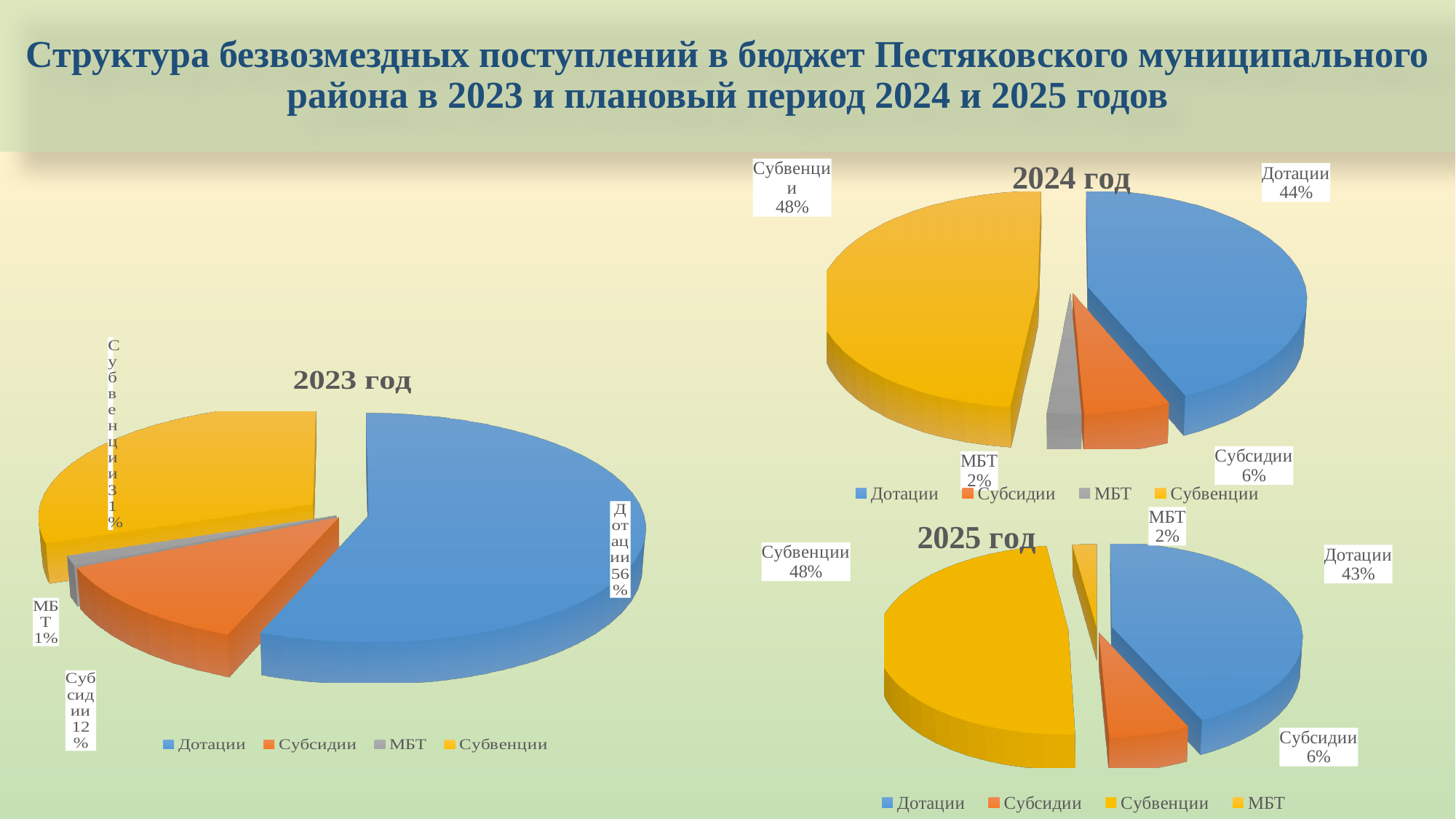
In the "2023 год" chart, which category has the smallest share? МБТ In the "2025 год" chart, what is the difference between the shares of Субвенции and Дотации? 5% In the "2025 год" chart, which is larger, Субсидии or МБТ? Субсидии In the "2023 год" chart, what is the difference between the shares of Дотации and Субсидии? 44% How many categories does the "2025 год" chart show? 4 In the "2024 год" chart, which category has the largest share? Субвенции In the "2024 год" chart, what share does МБТ have? 2% In the "2023 год" chart, what share does Дотации have? 56% In the "2025 год" chart, what share does Дотации have? 43% What type of chart is the "2024 год" chart? Pie chart In the "2024 год" chart, what share does Субвенции have? 48% In the "2023 год" chart, what share does Субвенции have? 31%